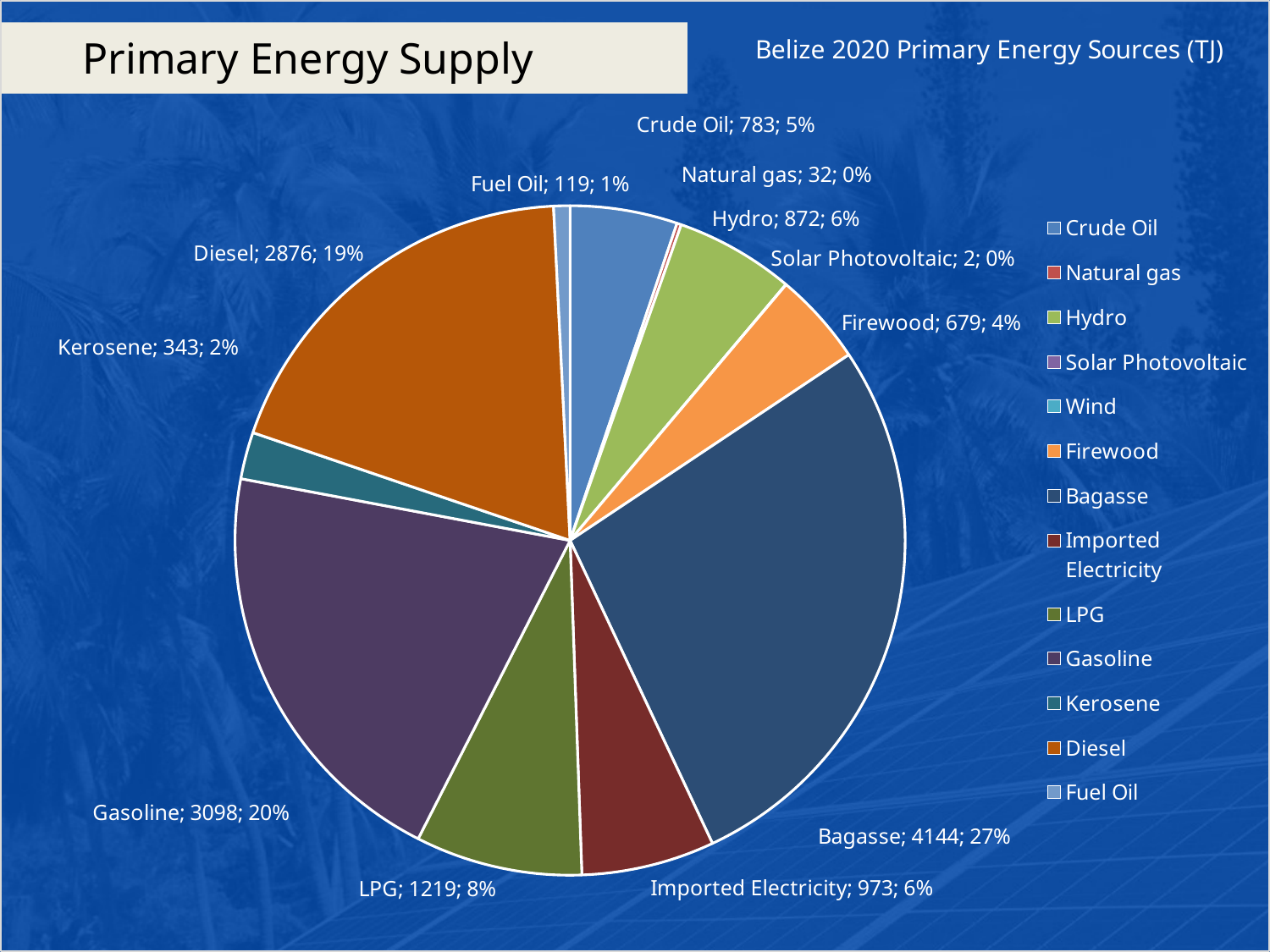
Which is larger, the value for LPG or the value for Imported Electricity? LPG Which energy source has the largest slice? Bagasse What is the value for Hydro? 872 What share of the pie does Diesel represent? 19% What is the title of the chart? Belize 2020 Primary Energy Sources (TJ) What is the difference between the values for Gasoline and Diesel? 222 What is the value for Bagasse? 4144 Which labelled energy source has the smallest value? Solar Photovoltaic How many energy sources does the legend list? 13 What share of the pie does Imported Electricity represent? 6% What type of chart is shown on the slide? pie chart What is the value for Gasoline? 3098